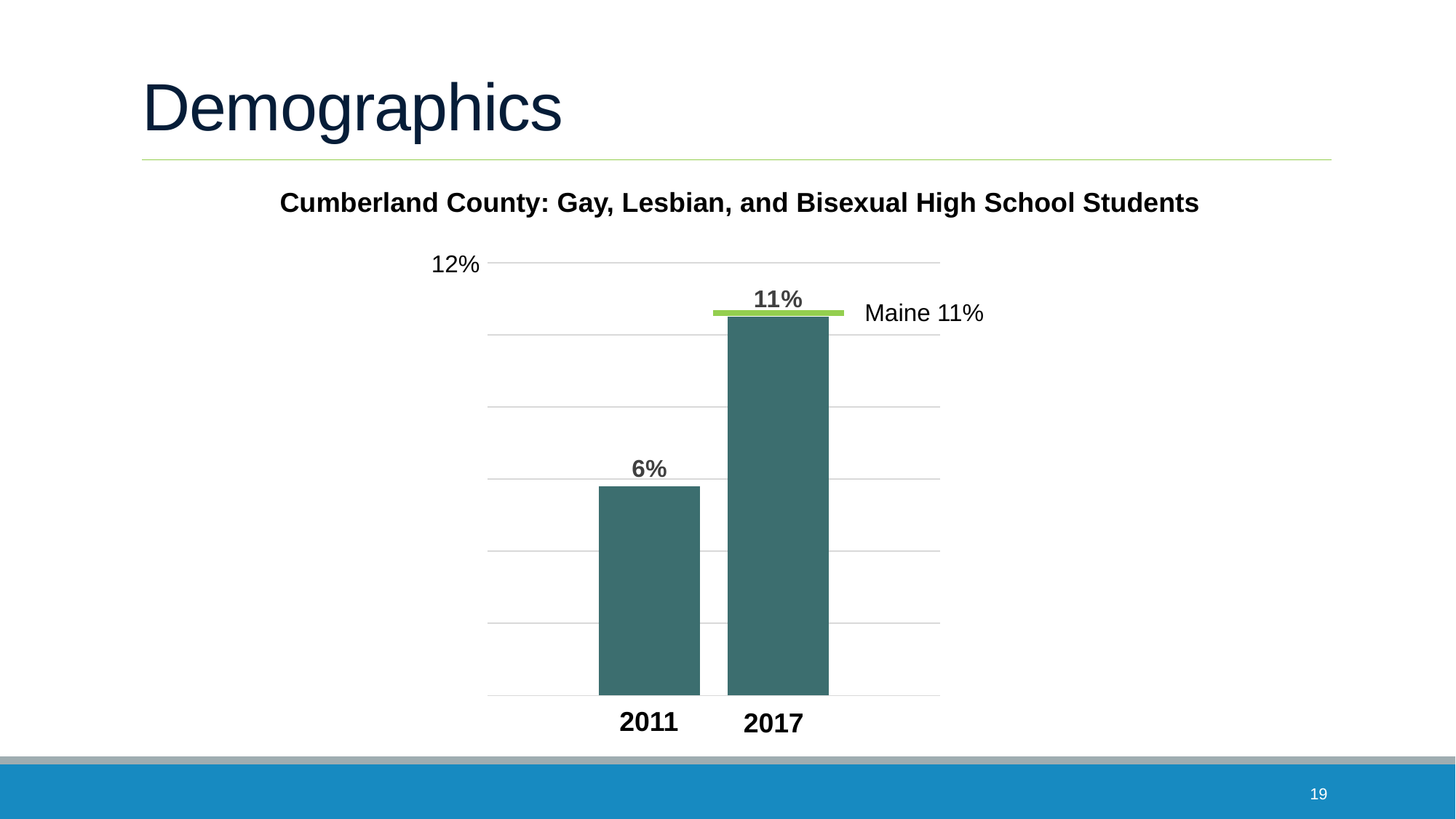
Is the value for 2017 larger than the value for 2011? Yes Which year has the lower value? 2011 How many bars are shown in the chart? 2 What is the title of the chart? Cumberland County: Gay, Lesbian, and Bisexual High School Students Which year has the higher value? 2017 What is the difference between the 2017 value and the 2011 value? 5% What kind of chart is shown on the slide? Bar chart Do the values rise or fall from 2011 to 2017? Rise Is the value for 2011 greater or less than 12%? less What is the value for 2017? 11% What value does the green reference line labelled Maine indicate? 11% What is the value for 2011? 6%